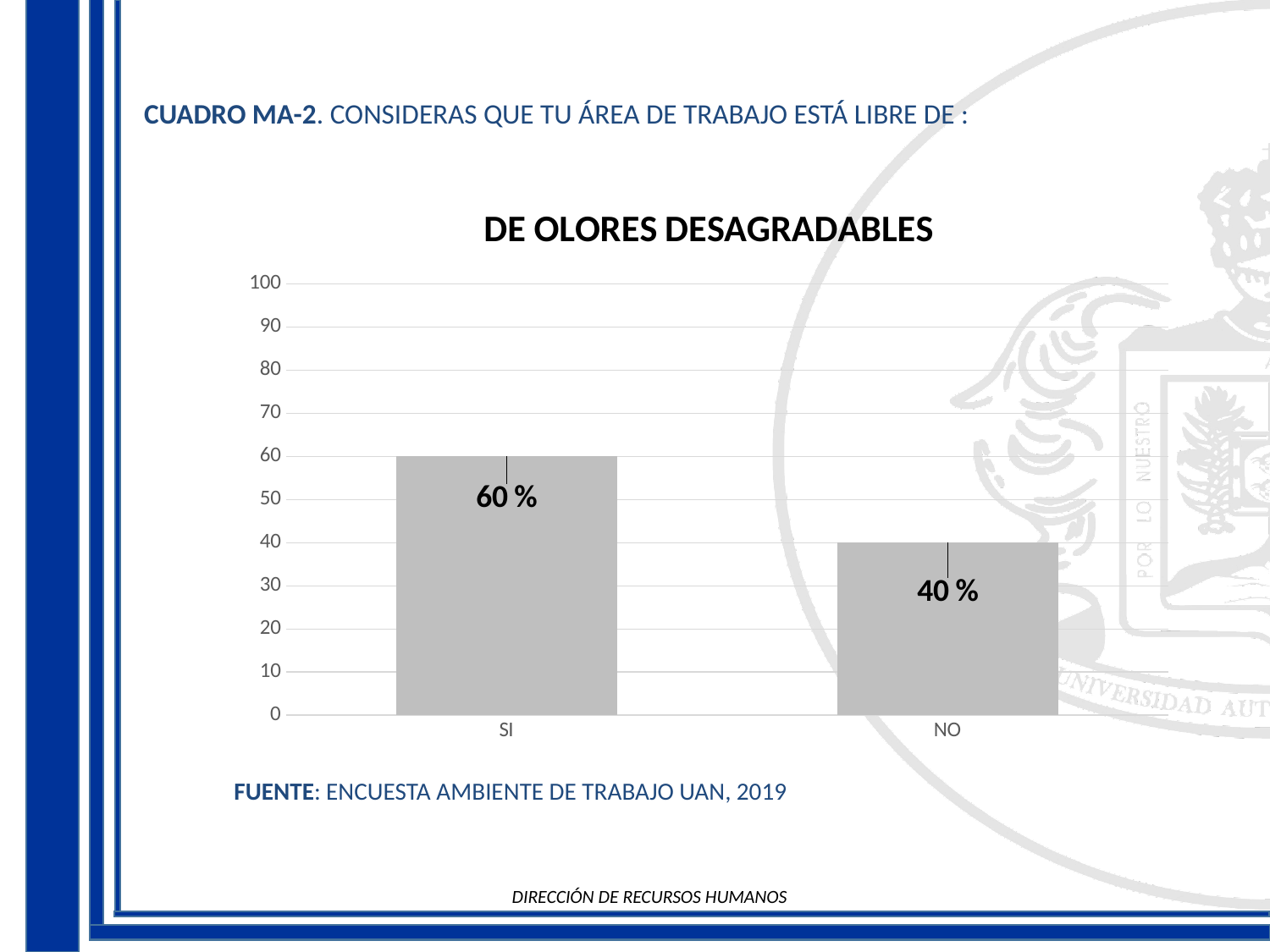
Which category has the lowest value? NO What is the value for NO? 40 % What is the difference between the values for SI and NO? 20 % What kind of chart is shown? bar chart What is the maximum value shown on the y axis? 100 What is the title of the chart? DE OLORES DESAGRADABLES Which category has the highest value? SI What is the value for SI? 60 % Which is larger, the value for SI or the value for NO? SI Is the value for SI greater or less than 50? greater Is the value for NO greater or less than 50? less How many categories are shown on the x axis? 2